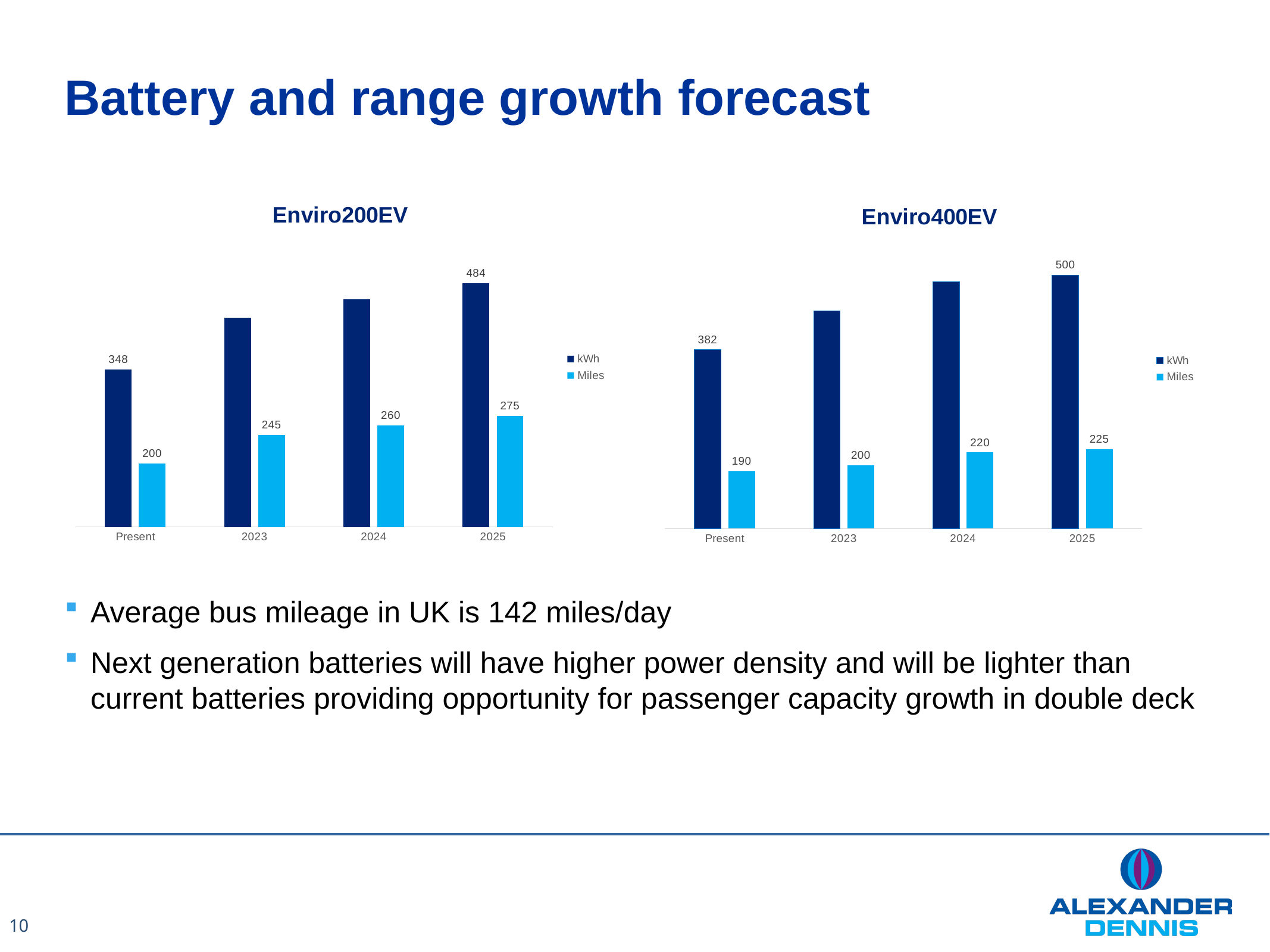
Which chart shows the larger Miles value for 2023, Enviro200EV or Enviro400EV? Enviro200EV In the Enviro200EV chart, what is the Miles value for 2024? 260 In the Enviro400EV chart, which category has the lowest Miles value? Present How many series does the legend of the Enviro200EV chart list? 2 In the Enviro200EV chart, what is the kWh value for 2025? 484 In the Enviro400EV chart, what is the Miles value for 2023? 200 In the Enviro400EV chart, what is the difference between the Miles value for 2025 and the Miles value for Present? 35 In the Enviro400EV chart, what is the kWh value for Present? 382 In the Enviro200EV chart, what is the difference between the kWh value for 2025 and the kWh value for Present? 136 In the Enviro400EV chart, do the kWh values rise or fall from Present to 2025? rise In the Enviro200EV chart, which category has the highest Miles value? 2025 How many categories are shown on the x axis of the Enviro400EV chart? 4